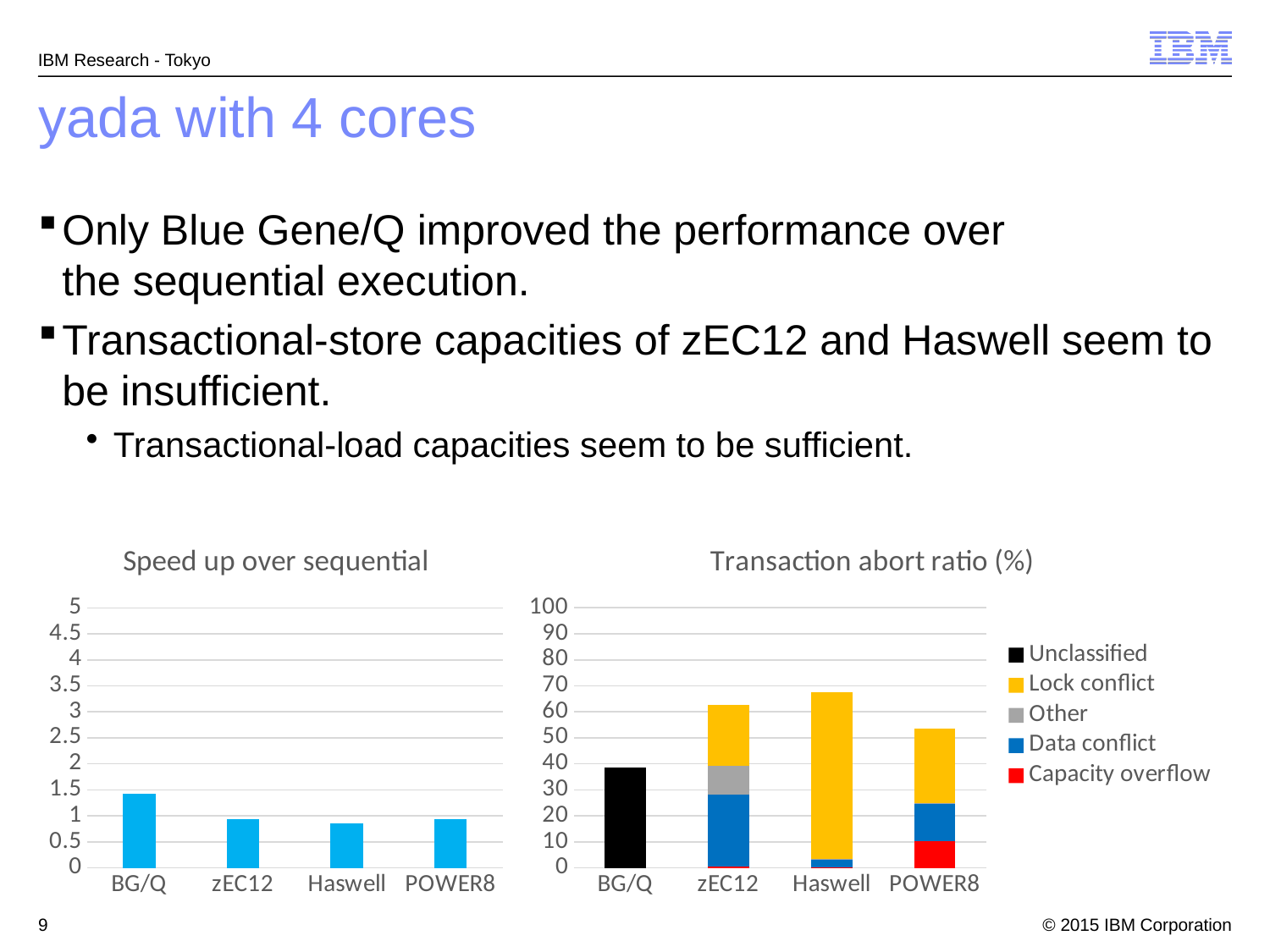
In the 'Speed up over sequential' chart, is the value for BG/Q greater or less than 1? greater What kind of chart is the 'Speed up over sequential' chart? bar chart In the 'Transaction abort ratio (%)' chart, which category has the lowest total abort ratio? BG/Q How many categories are shown on the x axis of the 'Speed up over sequential' chart? 4 In the 'Transaction abort ratio (%)' chart, which category's bar consists entirely of the 'Unclassified' series? BG/Q In the 'Speed up over sequential' chart, which category has the highest speed up? BG/Q In the 'Transaction abort ratio (%)' chart, is the total for Haswell greater or less than 60? greater How many series does the legend of the 'Transaction abort ratio (%)' chart list? 5 In the 'Transaction abort ratio (%)' chart, which category has the largest 'Capacity overflow' segment? POWER8 In the 'Speed up over sequential' chart, which is larger, the value for BG/Q or the value for zEC12? BG/Q In the 'Transaction abort ratio (%)' chart, is the total for BG/Q greater or less than 30? greater